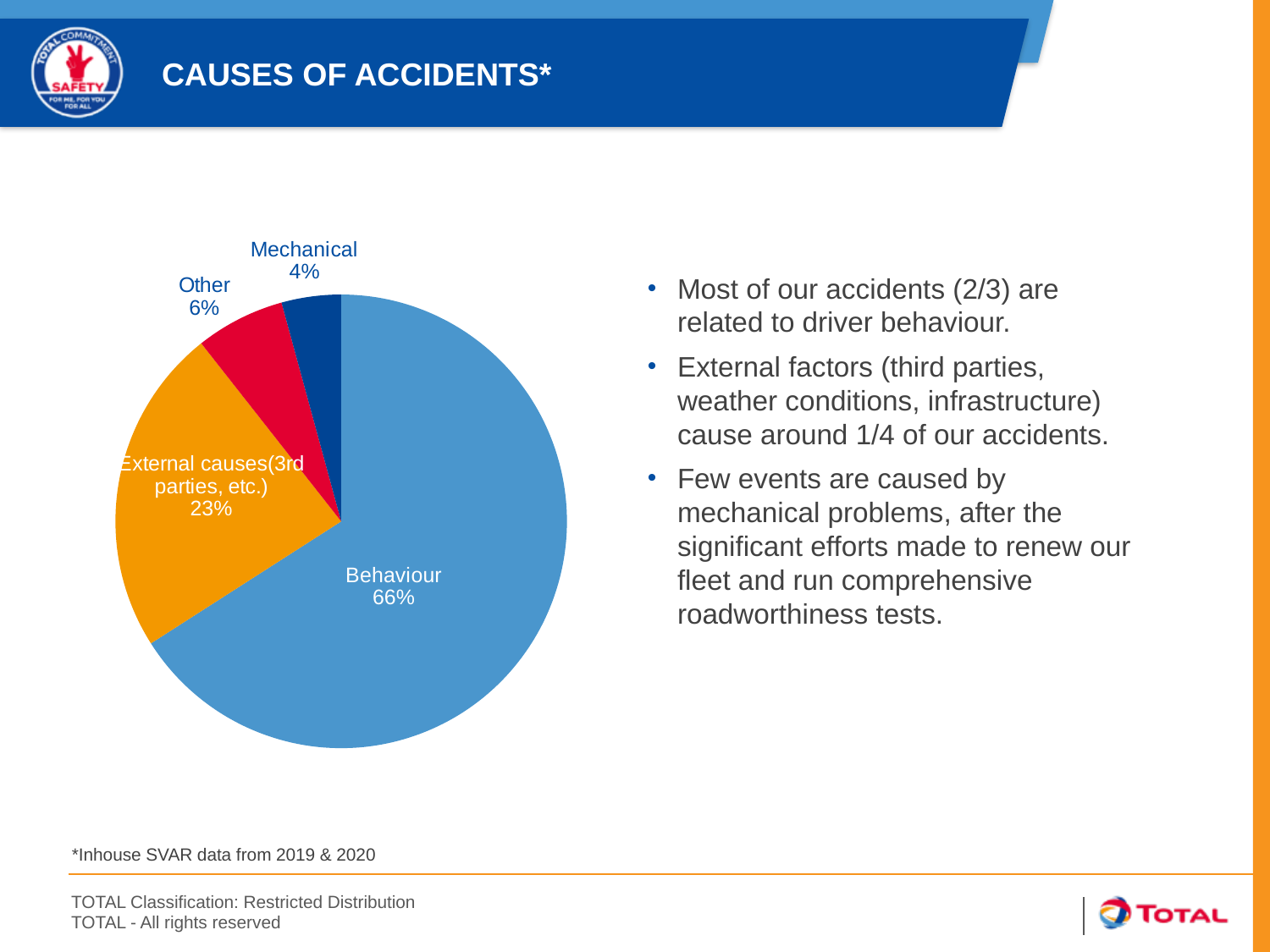
What share of accidents is attributed to Other causes? 6% How many slices does the pie chart have? 4 What share of accidents is attributed to External causes (3rd parties, etc.)? 23% What is the difference in percentage points between Behaviour and External causes? 43 What is the combined share of Other and Mechanical causes? 10% Which cause of accidents has the largest share? Behaviour What kind of chart is shown on the slide? Pie chart What share of accidents is attributed to Mechanical causes? 4% Which cause of accidents has the smallest share? Mechanical What share of accidents is attributed to Behaviour? 66% Which is larger, the share for Other or the share for Mechanical? Other What is the title of the chart on the slide? CAUSES OF ACCIDENTS*